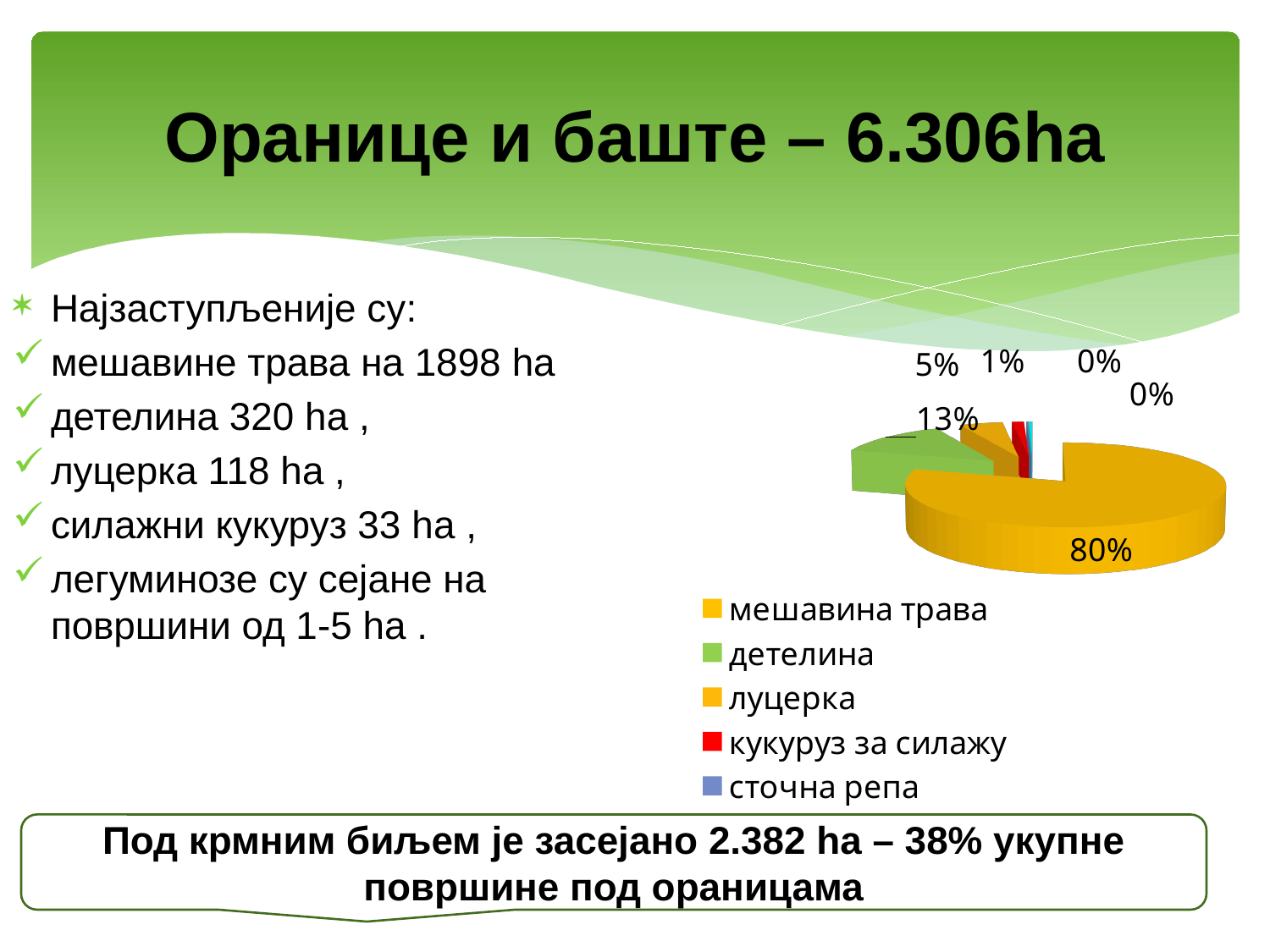
Which category has the largest slice of the pie? мешавина трава What is the difference in percentage points between the мешавина трава slice and the детелина slice? 67 percentage points What colour is the slice for мешавина трава? yellow What share of the pie does мешавина трава have? 80% Which is larger, the slice for детелина or the slice for луцерка? детелина Which category is listed first in the legend? мешавина трава How many entries does the chart legend list? 5 What share of the pie does детелина have? 13% What share of the pie does кукуруз за силажу have? 1% What share of the pie does луцерка have? 5% What kind of chart is shown on the slide? pie chart